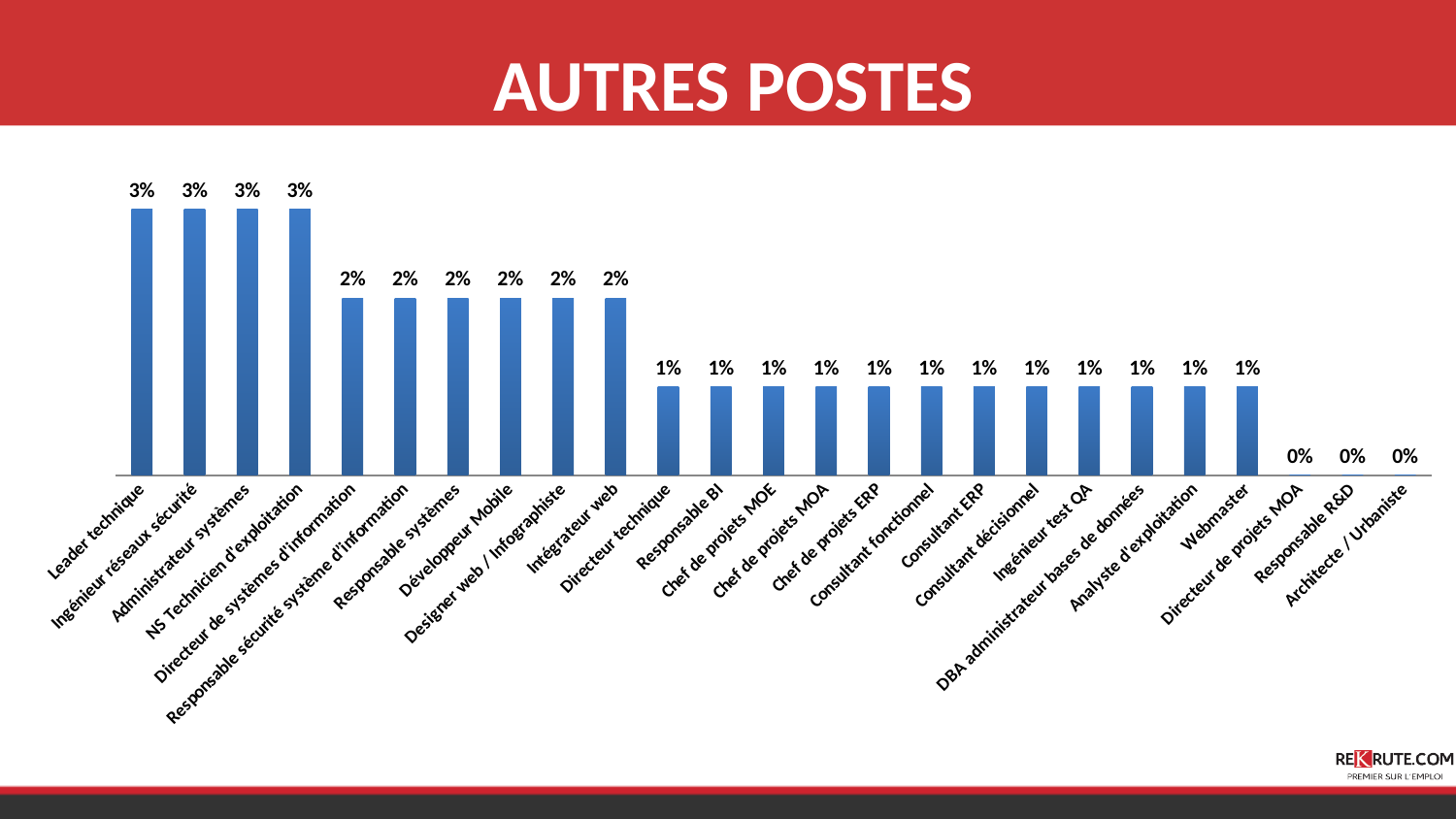
What is the value for Leader technique? 3% What kind of chart is shown on the slide? Bar chart What is the value for Webmaster? 1% What is the difference between the values for Administrateur systèmes and Intégrateur web? 1% What is the difference between the values for NS Technicien d'exploitation and Chef de projets MOA? 2% Which is larger, the value for Responsable BI or the value for Responsable systèmes? Responsable systèmes Which is larger, the value for Ingénieur réseaux sécurité or the value for Directeur technique? Ingénieur réseaux sécurité What is the value for Développeur Mobile? 2% What is the value for Consultant ERP? 1% What is the value for Responsable R&D? 0% What is the title of the slide? AUTRES POSTES How many categories are shown in the chart? 25